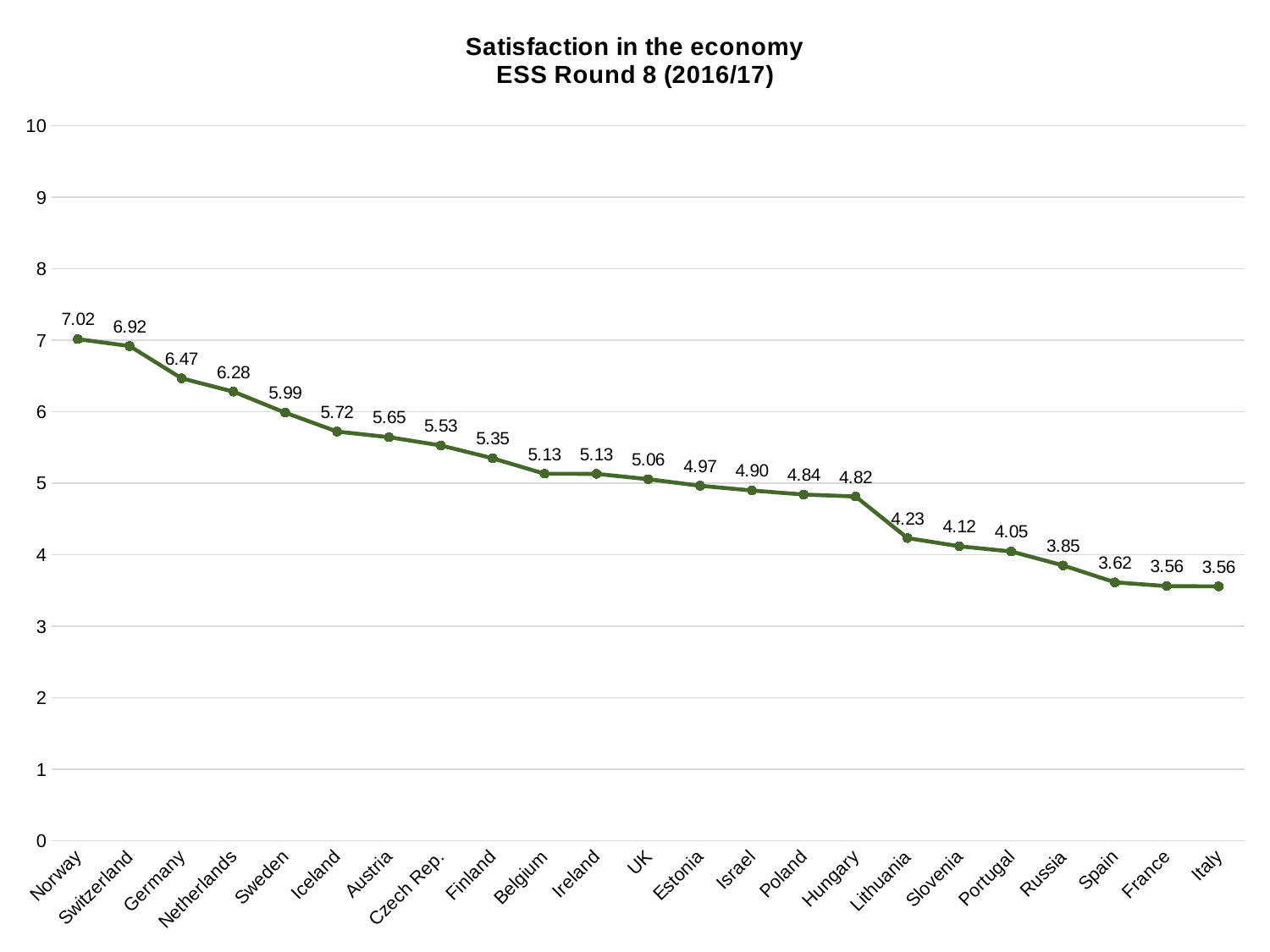
Which has a larger value, Sweden or Iceland? Sweden What is the title of the chart? Satisfaction in the economy ESS Round 8 (2016/17) What is the difference between the values for Hungary and Lithuania? 0.59 What is the value for Spain? 3.62 What kind of chart is this? line chart What is the value for Germany? 6.47 What is the difference between the values for Norway and Italy? 3.46 Is the value for Portugal greater or less than 5? less Which country has the highest value? Norway Do the values rise or fall from left to right along the x axis? fall How many countries are plotted on the chart? 23 What is the value for Hungary? 4.82